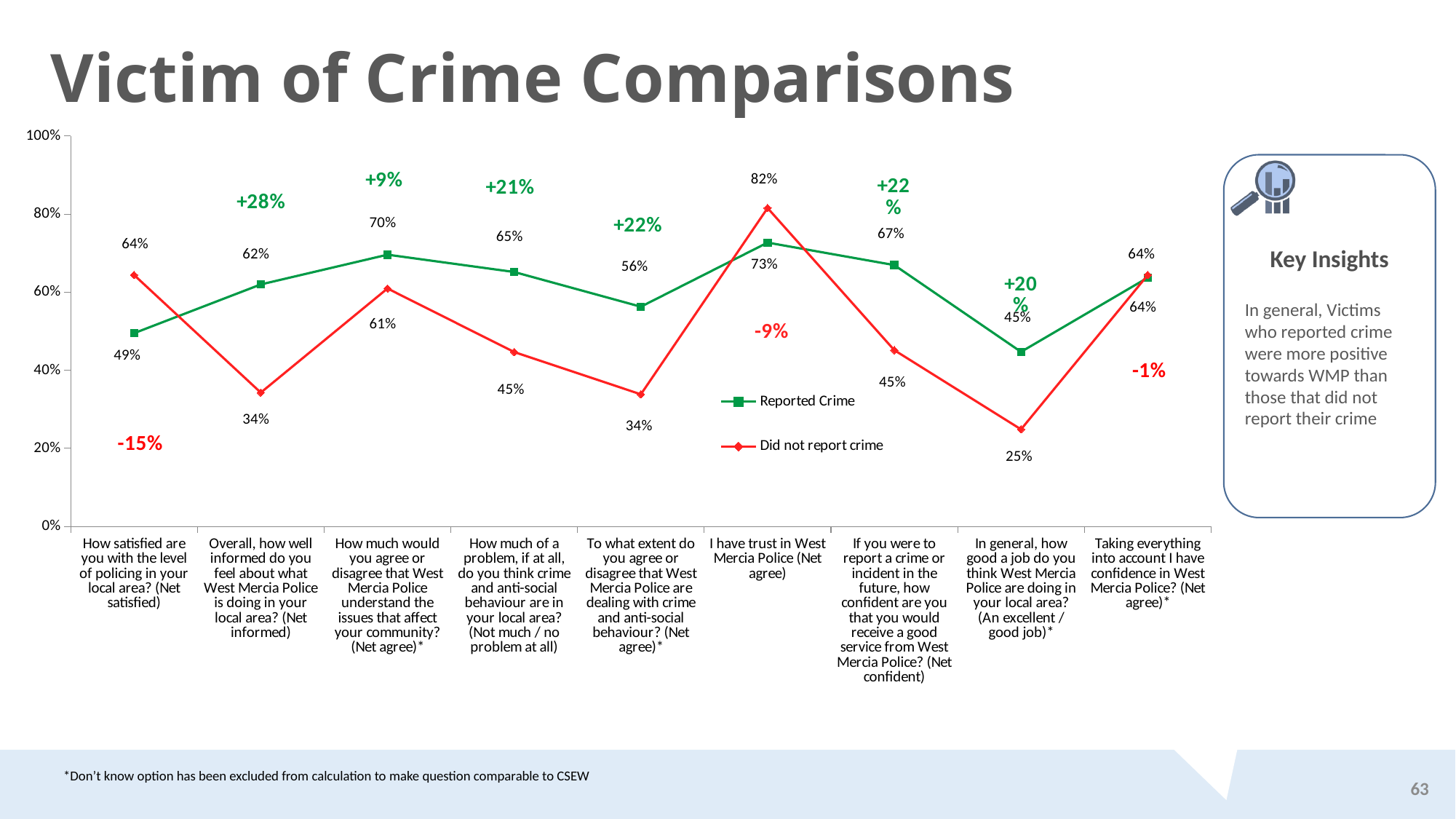
How many questions (categories) are plotted on the x axis? 9 What kind of chart is shown on the slide? Line chart Which series has the larger value on 'How satisfied are you with the level of policing in your local area? (Net satisfied)'? Did not report crime What colour is the line for the Reported Crime series? Green What is the value for Did not report crime on 'How satisfied are you with the level of policing in your local area? (Net satisfied)'? 64% What is the value for Reported Crime on 'I have trust in West Mercia Police (Net agree)'? 73% How many series does the legend list? 2 What is the difference between Reported Crime and Did not report crime on 'Overall, how well informed do you feel about what West Mercia Police is doing in your local area? (Net informed)'? 28% What is the value for Did not report crime on 'In general, how good a job do you think West Mercia Police are doing in your local area? (An excellent / good job)'? 25% Which question has the lowest value for the Reported Crime series? In general, how good a job do you think West Mercia Police are doing in your local area? (An excellent / good job) Which question has the highest value for the Did not report crime series? I have trust in West Mercia Police (Net agree) Which question has the highest value for the Reported Crime series? I have trust in West Mercia Police (Net agree)